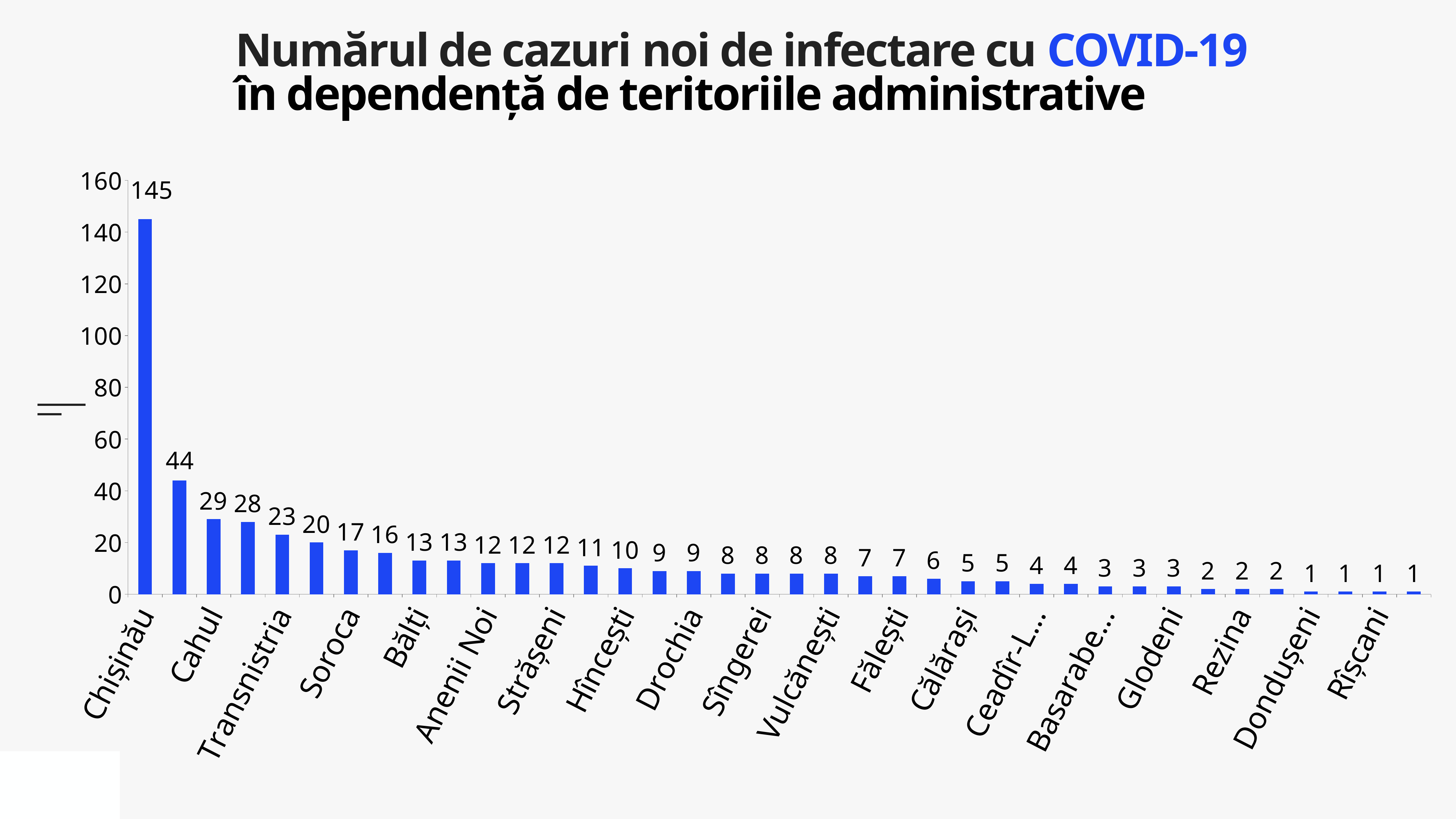
Which has more new cases, Chișinău or Rezina? Chișinău Which administrative territory has the highest number of new COVID-19 cases? Chișinău What is the difference between the values for Chișinău and Rîșcani? 144 What type of chart is shown on the slide? bar chart Do the values rise or fall moving from left to right along the x axis? fall Is the value for Chișinău greater or less than 140? greater How many new COVID-19 cases are shown for Rezina? 2 How many bars are plotted in the chart? 38 How many new COVID-19 cases are shown for Chișinău? 145 How many new COVID-19 cases are shown for Glodeni? 3 How many new COVID-19 cases are shown for Rîșcani? 1 How many new COVID-19 cases are shown for Strășeni? 12